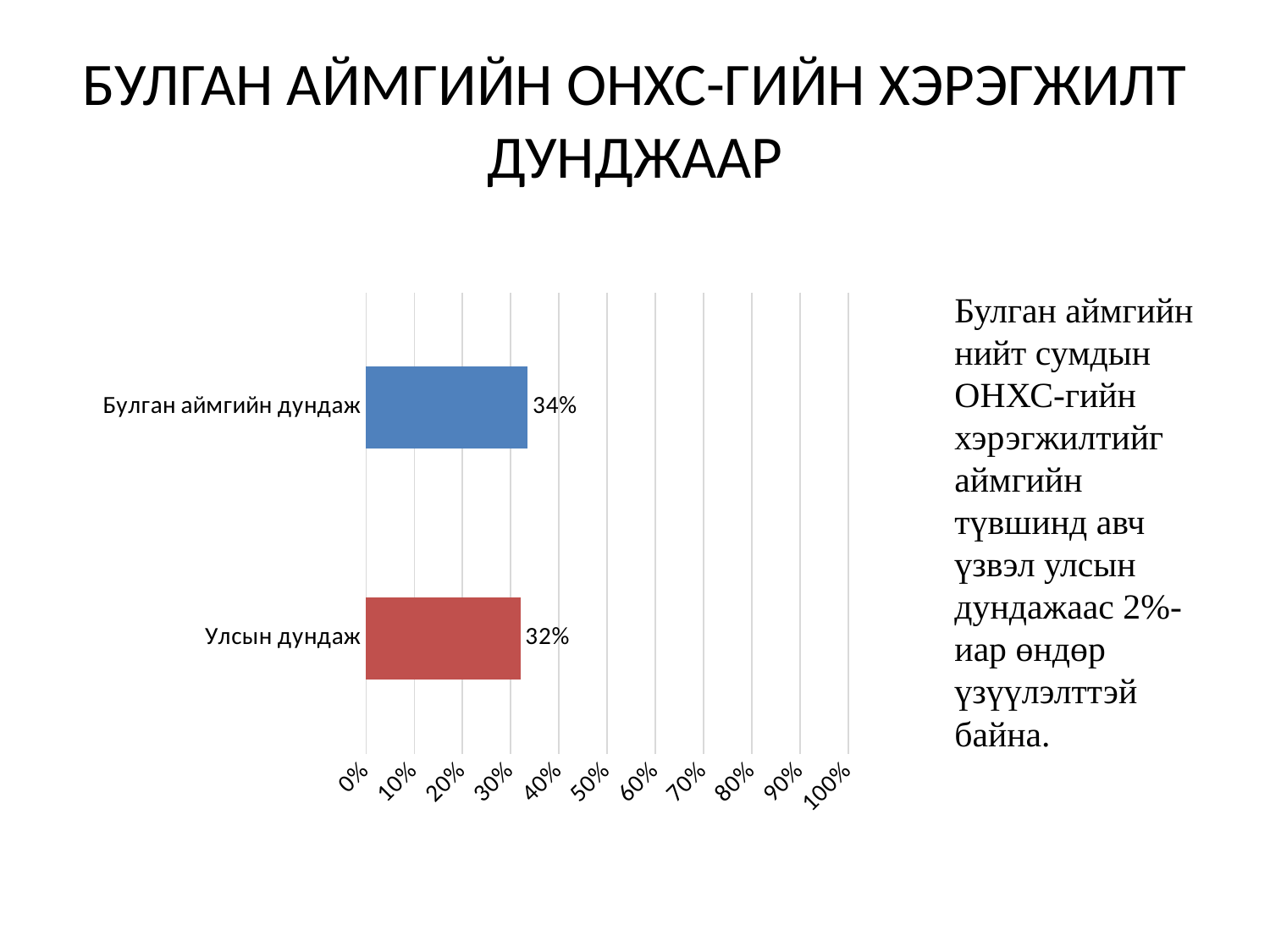
Is the value for Улсын дундаж greater or less than 50%? less What is the maximum value shown on the horizontal axis? 100% Which is larger, the value for Булган аймгийн дундаж or the value for Улсын дундаж? Булган аймгийн дундаж Is the value for Булган аймгийн дундаж greater or less than 20%? greater What is the difference between the values for Булган аймгийн дундаж and Улсын дундаж? 2% How many categories are shown in the chart? 2 Which category has the highest value? Булган аймгийн дундаж Which category has the lowest value? Улсын дундаж What is the value for Булган аймгийн дундаж? 34% What is the value for Улсын дундаж? 32% What colour is the bar for Улсын дундаж? red What kind of chart is shown on the slide? bar chart